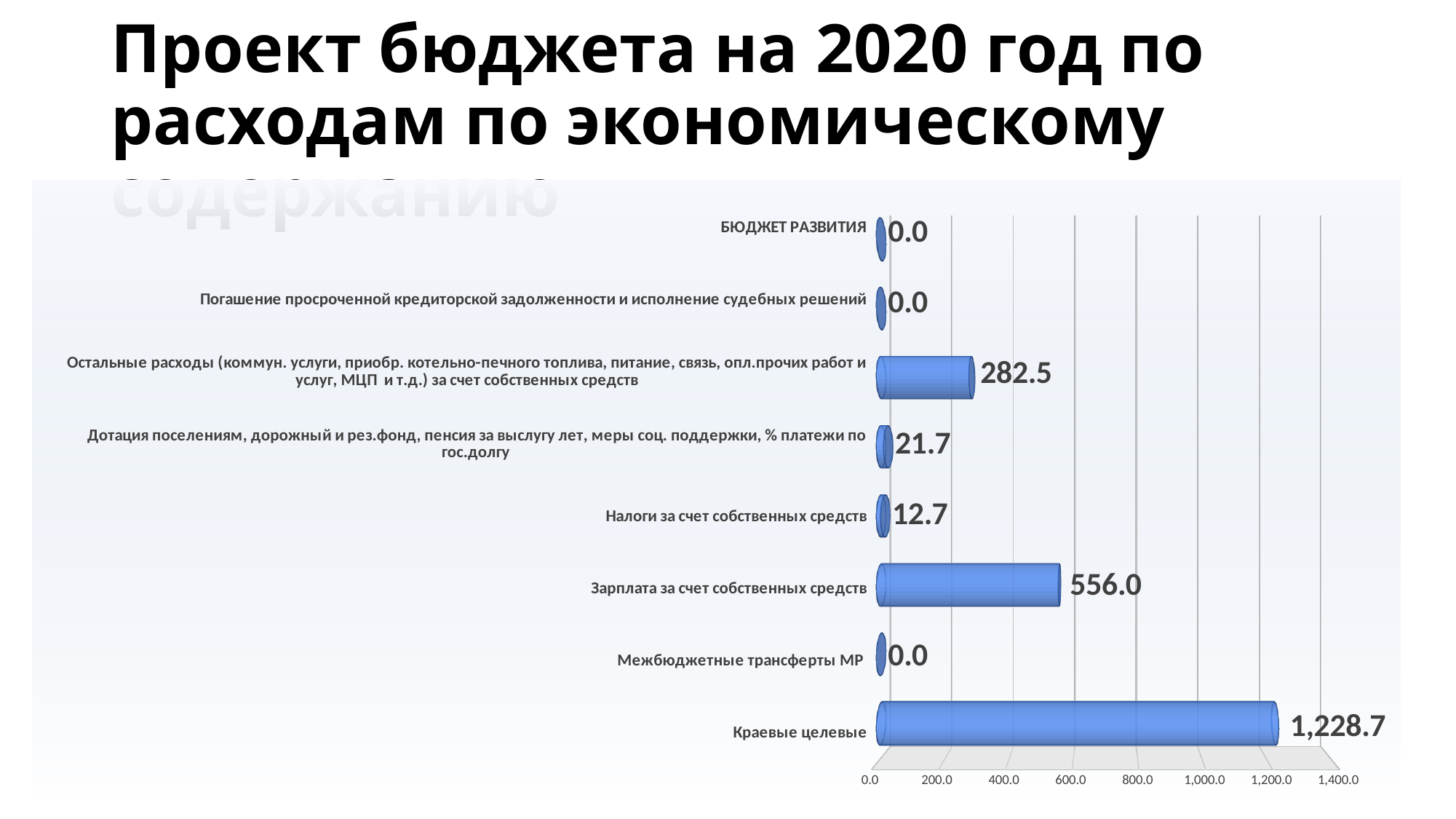
How many categories have a value of 0.0? 3 Which is larger: the value for Зарплата за счет собственных средств or the value for Остальные расходы за счет собственных средств? Зарплата за счет собственных средств Which category has the highest value? Краевые целевые What is the value for Налоги за счет собственных средств? 12.7 What is the value for Остальные расходы (коммун. услуги, приобр. котельно-печного топлива, питание, связь, опл.прочих работ и услуг, МЦП и т.д.) за счет собственных средств? 282.5 What is the value for Межбюджетные трансферты МР? 0.0 What is the value for Зарплата за счет собственных средств? 556.0 What is the value for Краевые целевые? 1,228.7 What is the difference between the values for Дотация поселениям, дорожный и рез.фонд, пенсия за выслугу лет, меры соц. поддержки, % платежи по гос.долгу and Налоги за счет собственных средств? 9.0 How many categories are shown in the chart? 8 What is the difference between the values for Краевые целевые and Зарплата за счет собственных средств? 672.7 What kind of chart is shown on the slide? Bar chart